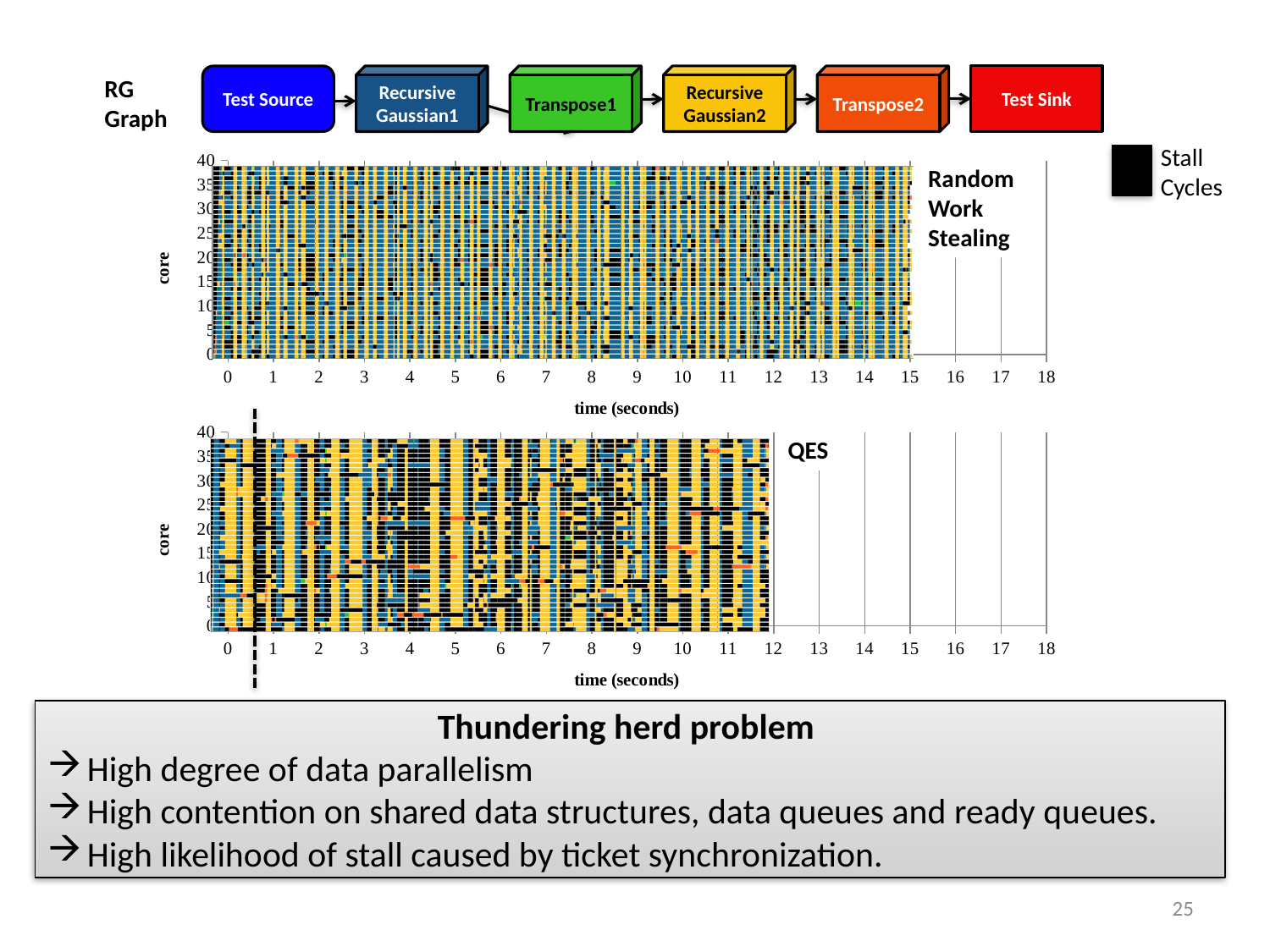
How many timeline charts are shown on the slide? 2 Which chart shows the execution finishing earlier, Random Work Stealing or QES? QES In the bottom chart (QES), does the execution end at a time greater or less than 13 seconds? less In the top chart (Random Work Stealing), does the execution end at a time greater or less than 16 seconds? less In the bottom chart (QES), does the execution end at a time greater or less than 10 seconds? greater What is the label of the top chart on the slide? Random Work Stealing According to the legend, what do the black regions in the charts represent? Stall Cycles Which chart shows a larger amount of black (stall cycles), Random Work Stealing or QES? QES